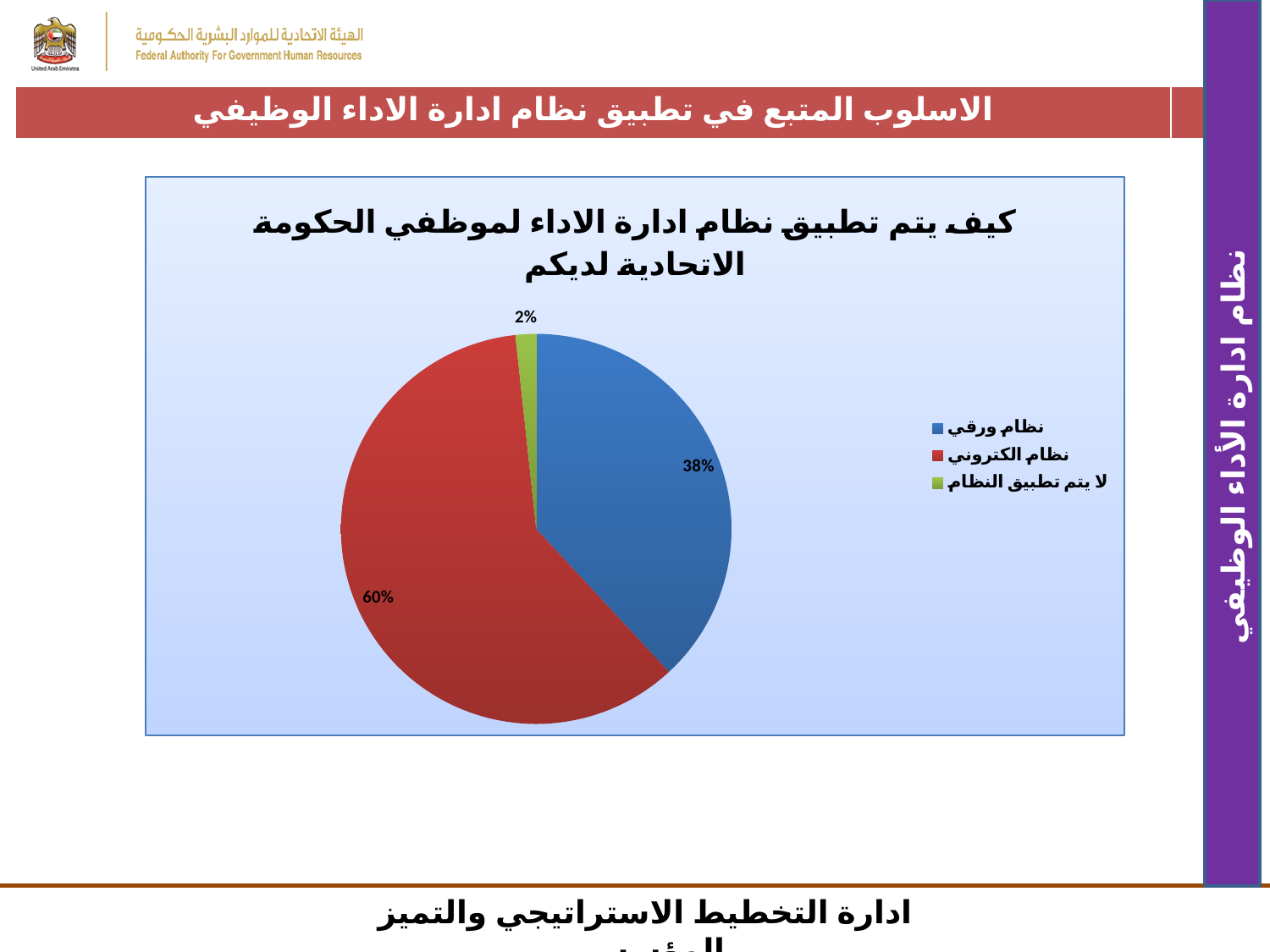
What share of the pie does "نظام الكتروني" represent? 60% What is the title of the chart? كيف يتم تطبيق نظام ادارة الاداء لموظفي الحكومة الاتحادية لديكم What is the difference in percentage points between "نظام الكتروني" and "نظام ورقي"? 22% What colour is the slice for "نظام الكتروني"? red How many entries does the legend list? 3 What type of chart is shown on the slide? pie chart What share of the pie does "نظام ورقي" represent? 38% How many categories does the pie chart show? 3 Which category has the largest slice of the pie? نظام الكتروني Which is larger, the slice for "نظام ورقي" or the slice for "لا يتم تطبيق النظام"? نظام ورقي What share of the pie does "لا يتم تطبيق النظام" represent? 2% Which category has the smallest slice of the pie? لا يتم تطبيق النظام